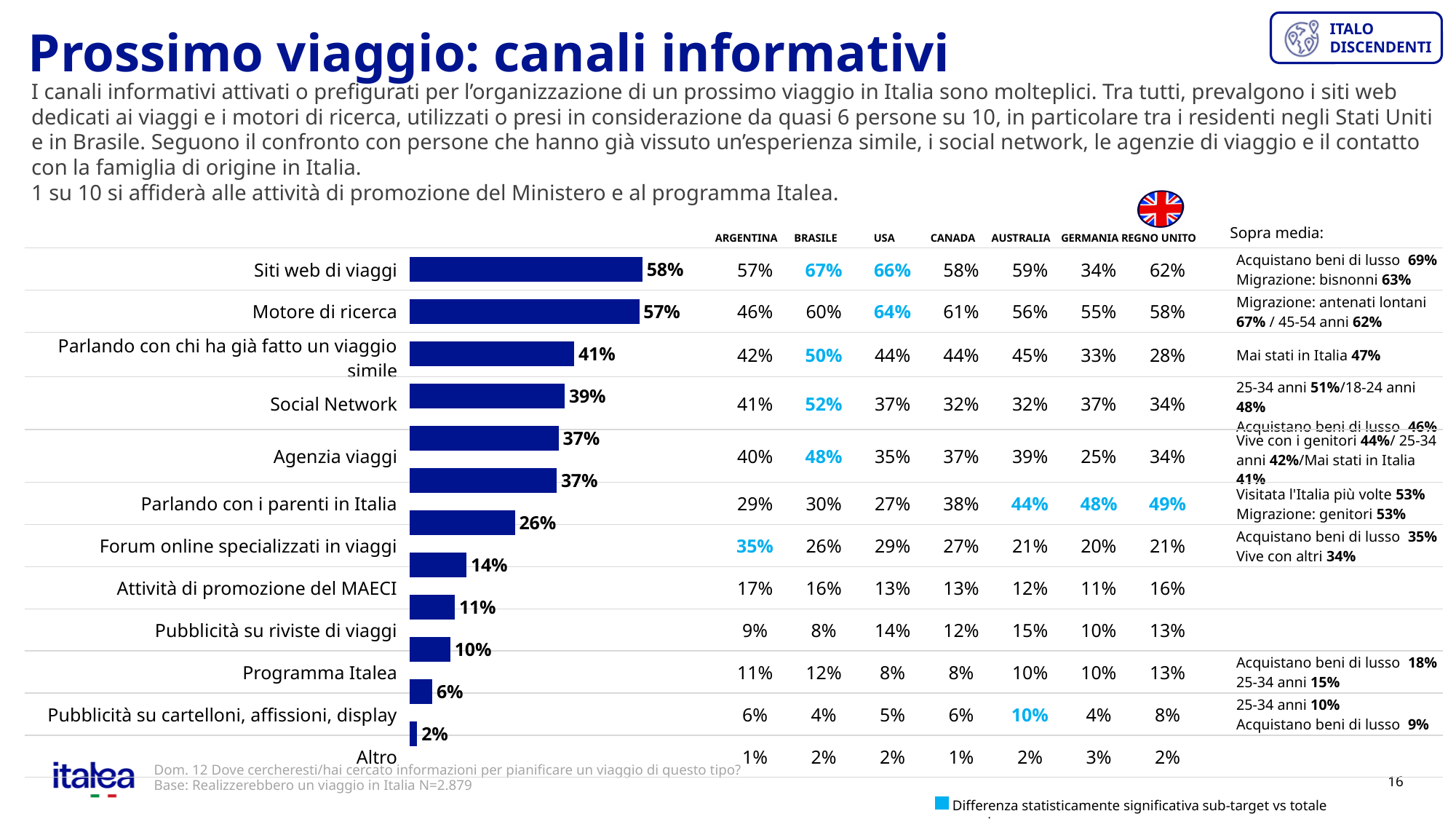
What type of chart is used on this slide? Bar chart Which is larger in the bar chart: "Social Network" or "Agenzia viaggi"? Social Network What is the difference between the values for "Social Network" and "Attività di promozione del MAECI" in the bar chart? 25% Which category has the lowest value in the bar chart? Altro How many categories are shown in the bar chart? 12 What percentage is shown for "Programma Italea" in the bar chart? 10% What percentage is shown for "Forum online specializzati in viaggi" in the bar chart? 26% How many country columns are shown in the table next to the bar chart? 7 In the table next to the chart, what is the value for "Motore di ricerca" in the USA column? 64% Which category has the highest value in the bar chart? Siti web di viaggi What percentage is shown for "Siti web di viaggi" in the bar chart? 58% What is the difference between the values for "Siti web di viaggi" and "Motore di ricerca" in the bar chart? 1%